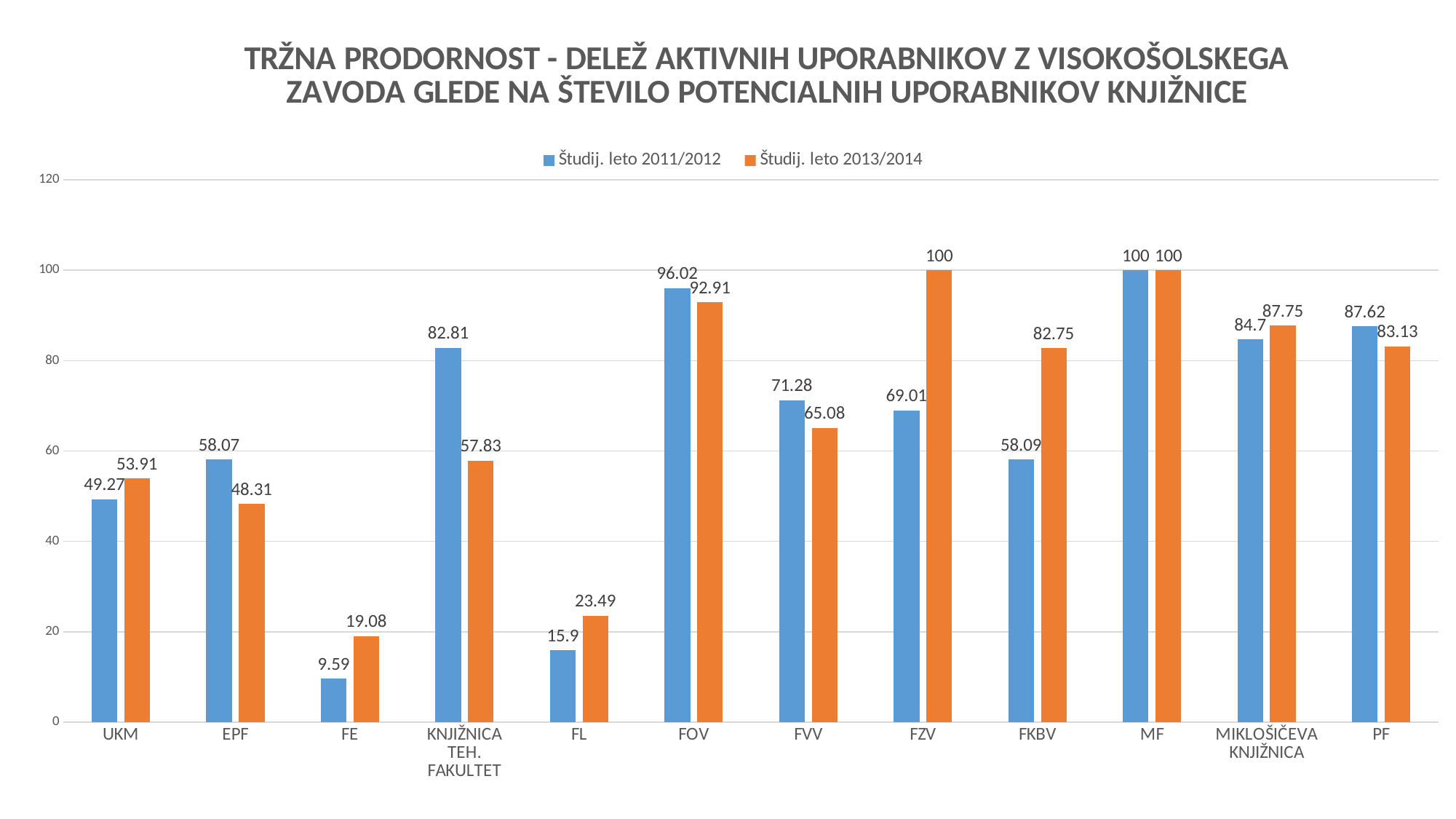
What is the value for FZV in the Študij. leto 2013/2014 series? 100 How many categories are shown on the x axis? 12 What kind of chart is shown on the slide? Bar chart What is the value for MIKLOŠIČEVA KNJIŽNICA in the Študij. leto 2011/2012 series? 84.7 How many series does the legend list? 2 What is the value for FE in the Študij. leto 2011/2012 series? 9.59 Which category has the lowest value in the Študij. leto 2013/2014 series? FE What is the value for KNJIŽNICA TEH. FAKULTET in the Študij. leto 2013/2014 series? 57.83 What is the difference between the Študij. leto 2013/2014 and Študij. leto 2011/2012 values for FZV? 30.99 Which category has the lowest value in the Študij. leto 2011/2012 series? FE Which category has the highest value in the Študij. leto 2011/2012 series? MF For EPF, which series has the larger value, Študij. leto 2011/2012 or Študij. leto 2013/2014? Študij. leto 2011/2012